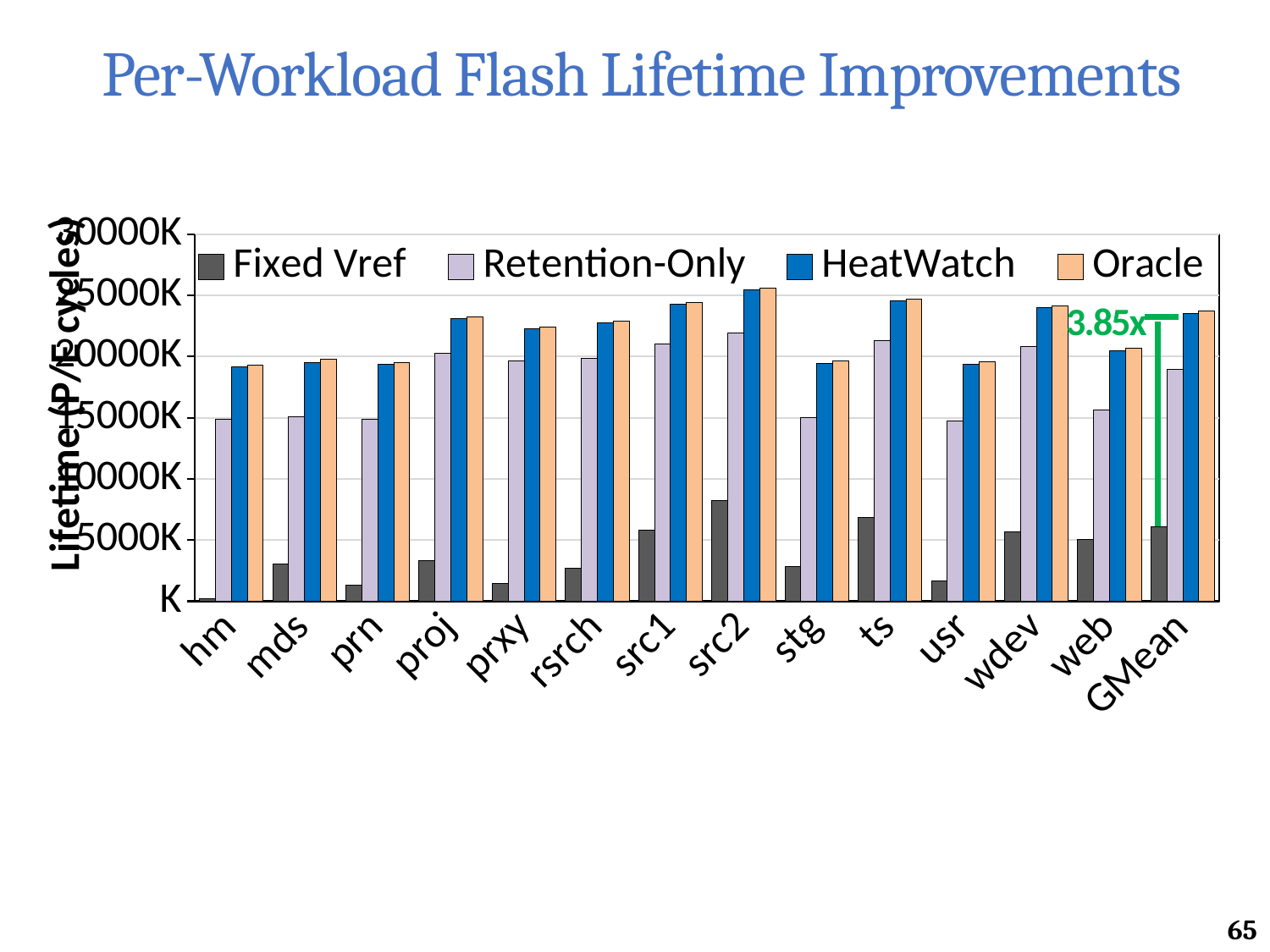
What improvement factor is annotated in green above the GMean bars? 3.85x What kind of chart is shown on the slide? bar chart For GMean, which is larger: the HeatWatch bar or the Fixed Vref bar? HeatWatch Is the Fixed Vref value for src2 greater or less than 5000K? greater Which workload has the highest Fixed Vref bar? src2 Which workload has the lowest Fixed Vref bar? hm Is the Retention-Only value for hm greater or less than 5000K? greater How many workload categories are shown on the x axis? 14 Which series are listed in the legend? Fixed Vref, Retention-Only, HeatWatch, Oracle For src2, which is larger: the Retention-Only bar or the Fixed Vref bar? Retention-Only How many series does the legend list? 4 Is the Fixed Vref value for hm greater or less than 5000K? less